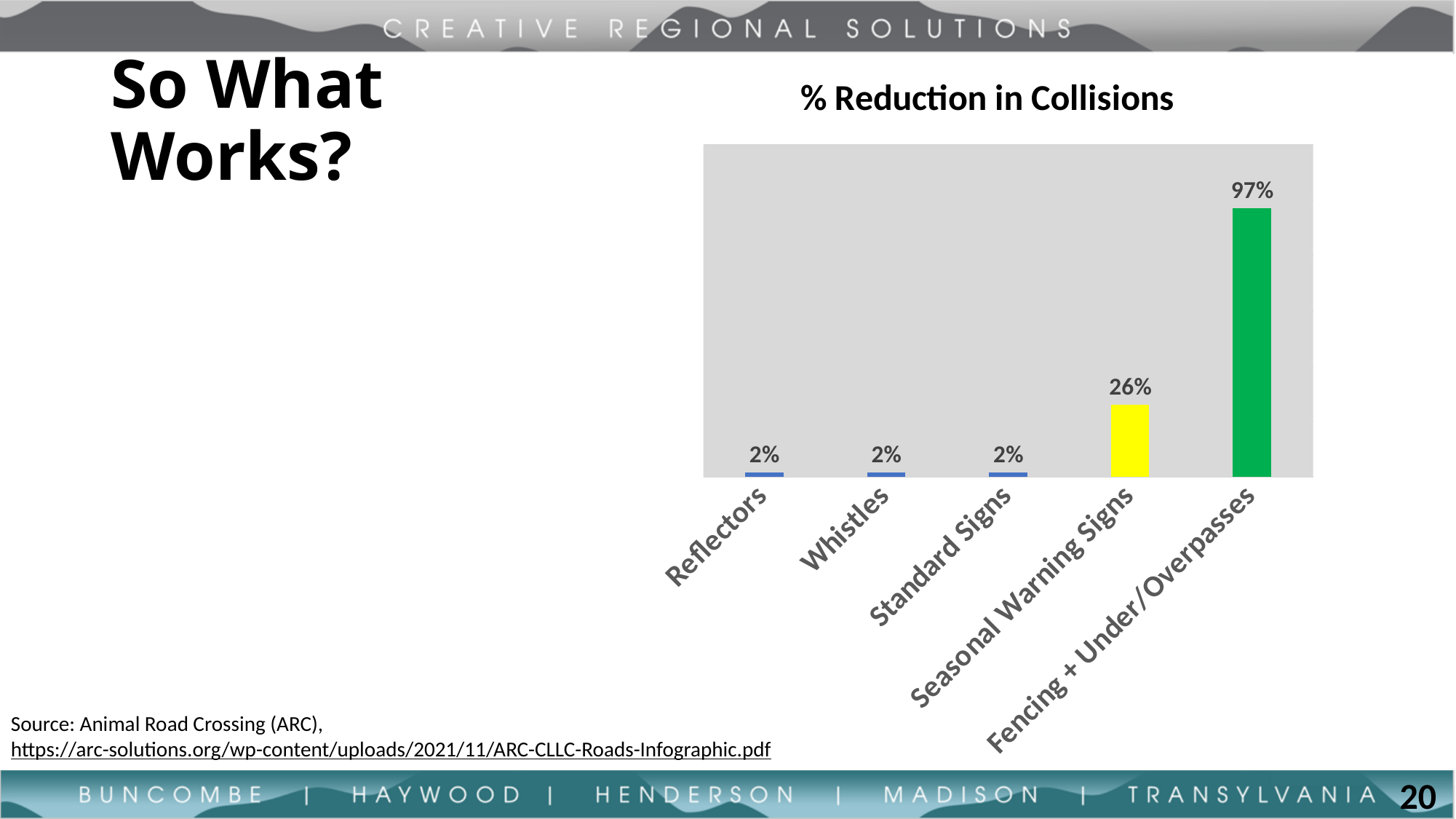
What colour is the bar for Fencing + Under/Overpasses? Green What is the % reduction in collisions for Seasonal Warning Signs? 26% How many categories are shown in the chart? 5 Which has a larger % reduction in collisions, Seasonal Warning Signs or Reflectors? Seasonal Warning Signs What is the difference in % reduction in collisions between Fencing + Under/Overpasses and Seasonal Warning Signs? 71% What kind of chart is shown on the slide? Bar chart What is the difference in % reduction in collisions between Seasonal Warning Signs and Standard Signs? 24% Do the values rise or fall moving from left to right across the categories? Rise What is the % reduction in collisions for Fencing + Under/Overpasses? 97% What is the % reduction in collisions for Whistles? 2% What is the title of the chart? % Reduction in Collisions Which category has the highest % reduction in collisions? Fencing + Under/Overpasses